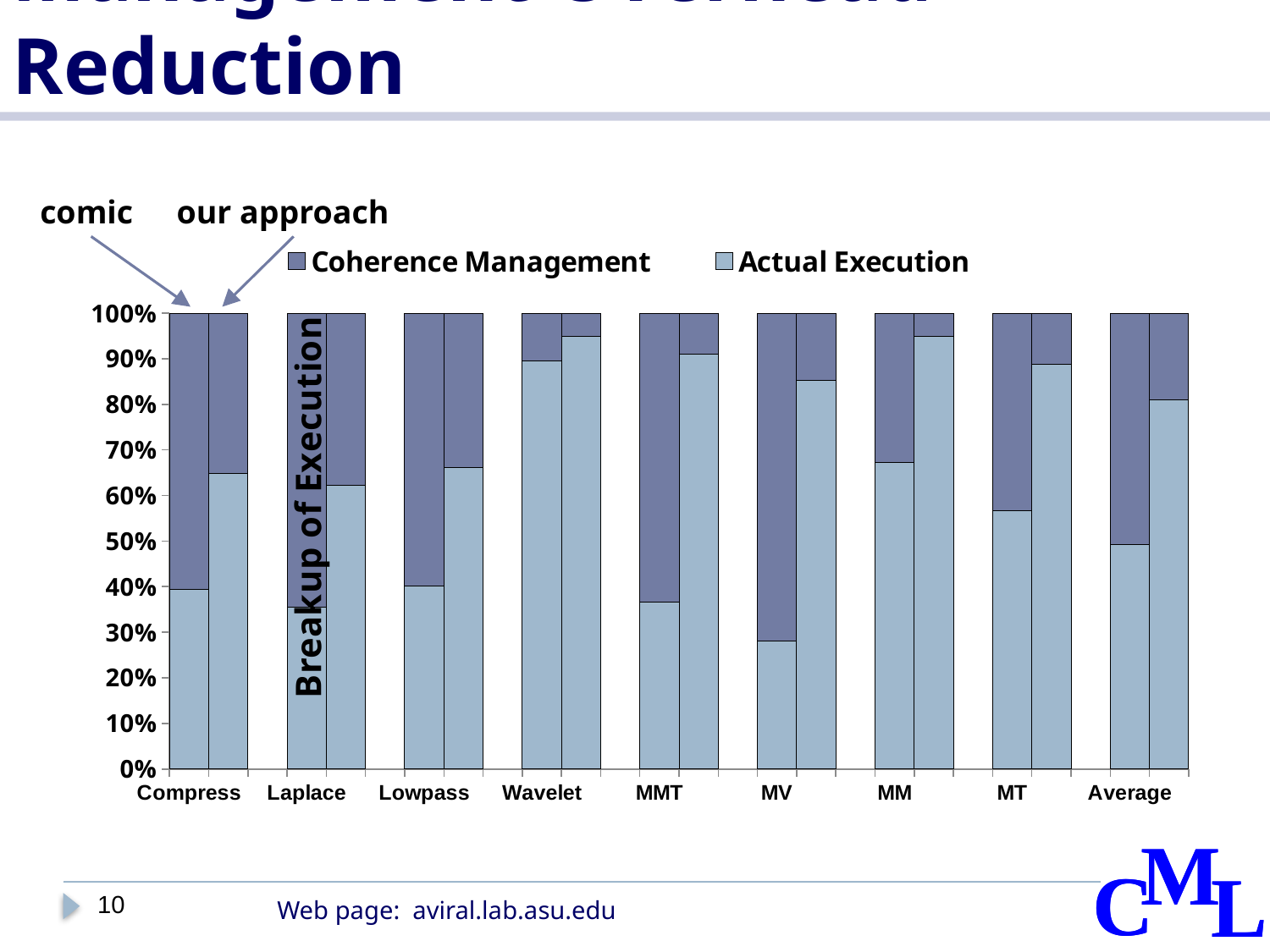
Is the Actual Execution share for the our approach bar of Wavelet greater or less than 90%? greater Is the Actual Execution share for the our approach bar of Average greater or less than 70%? greater What is the title of the vertical axis? Breakup of Execution How many series does the legend list? 2 How many benchmark categories are shown along the x axis? 9 Is the Actual Execution share for the comic bar of Average greater or less than 60%? less Which two series are listed in the legend? Coherence Management and Actual Execution Among the comic bars, which category has the lowest Actual Execution share? MV What kind of chart is shown on the slide? stacked bar chart Among the comic bars, which category has the highest Actual Execution share? Wavelet For Compress, which bar has the larger Actual Execution share, comic or our approach? our approach